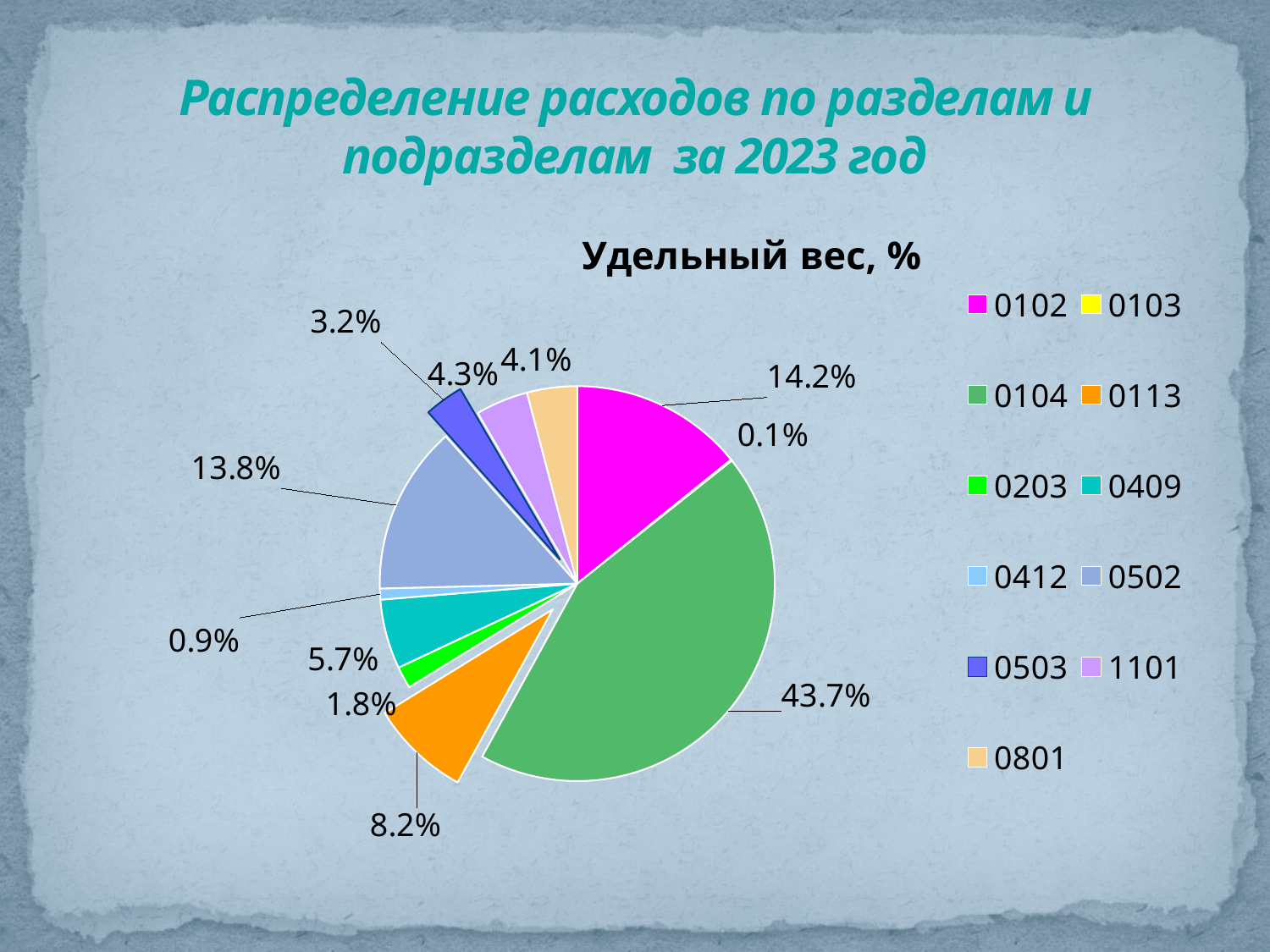
Which category has the larger share, 0102 or 0502? 0102 Which category has the smallest share of the pie? 0103 What is the difference between the shares of 0104 and 0102? 29.5% What is the title of the chart? Удельный вес, % Which category has the largest share of the pie? 0104 What is the share for category 0104? 43.7% How many categories does the legend of the pie chart list? 11 What is the share for category 0409? 5.7% What kind of chart is shown on the slide? pie chart What is the share for category 0502? 13.8% What is the share for category 0102? 14.2% What is the share for category 0113? 8.2%